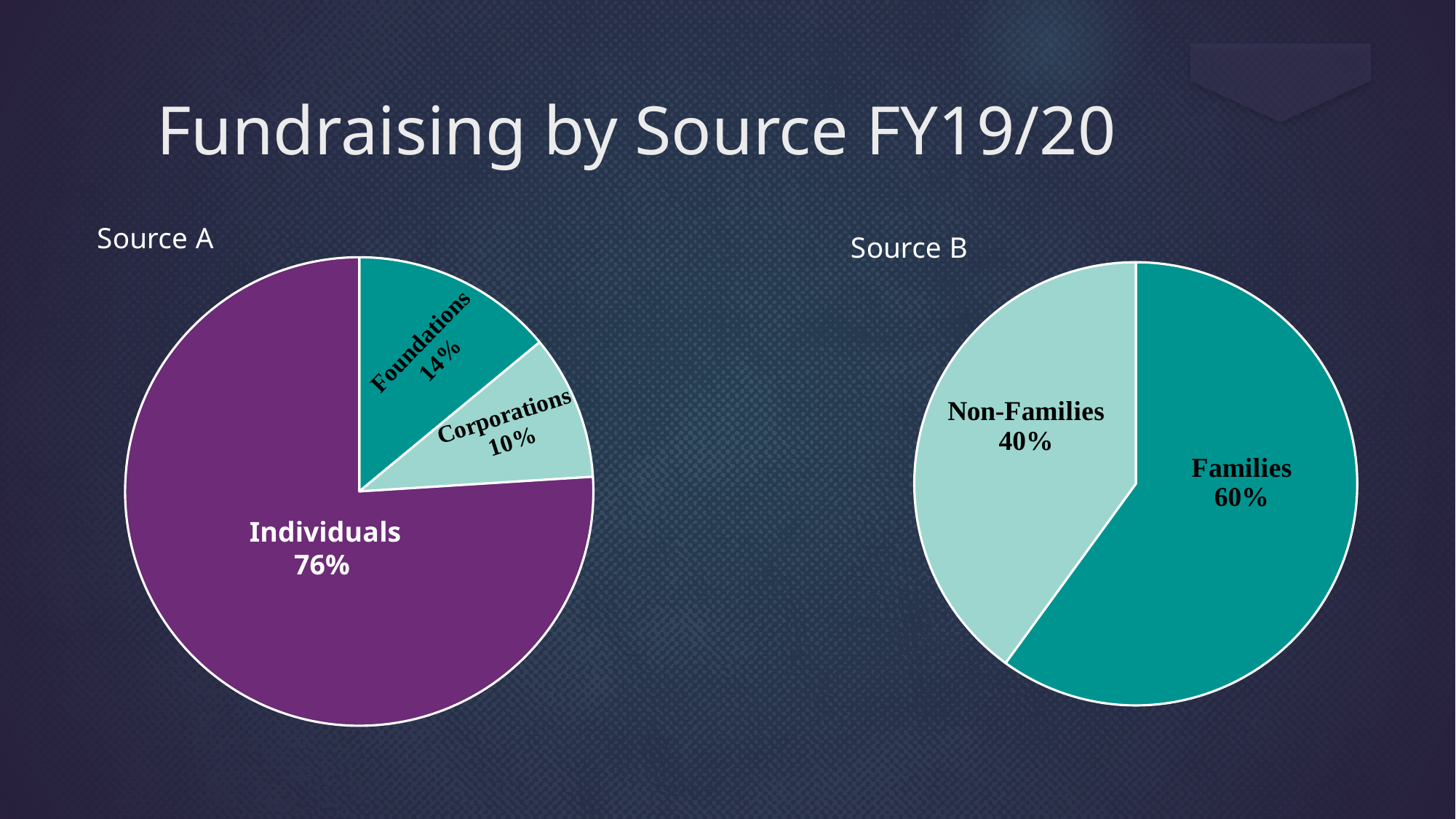
In the Source B chart, which category has the larger share? Families In the Source B chart, what share of fundraising comes from Families? 60% What kind of chart is the Source B chart? Pie chart In the Source A chart, which category has the largest share? Individuals In the Source A chart, what is the difference in percentage points between Individuals and Foundations? 62 In the Source B chart, what is the difference in percentage points between Families and Non-Families? 20 How many categories does the Source A chart show? 3 In the Source A chart, which category has the smallest share? Corporations In the Source B chart, what share of fundraising comes from Non-Families? 40% In the Source A chart, what share of fundraising comes from Individuals? 76% In the Source A chart, what share of fundraising comes from Foundations? 14% In the Source A chart, what share of fundraising comes from Corporations? 10%